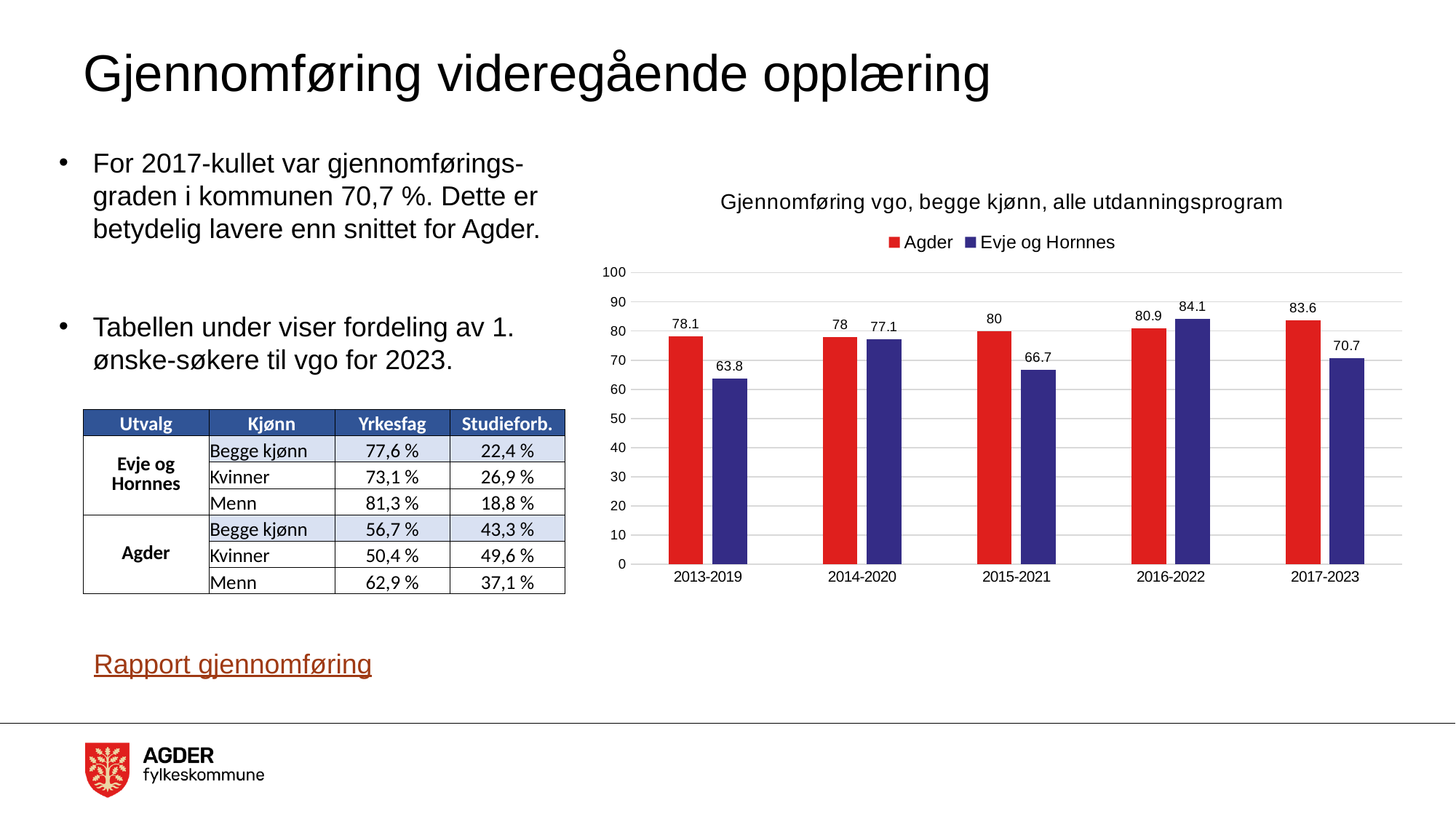
What is the difference between Agder and Evje og Hornnes in 2013-2019? 14.3 In which period is the Agder value highest? 2017-2023 Which is larger in 2016-2022, Agder or Evje og Hornnes? Evje og Hornnes In which period is the Evje og Hornnes value lowest? 2013-2019 What is the value for Evje og Hornnes in 2015-2021? 66.7 What is the value for Agder in 2013-2019? 78.1 How many periods are shown on the x axis? 5 Is the value for Evje og Hornnes in 2014-2020 greater or less than 70? greater What kind of chart is shown? Bar chart How many series does the legend list? 2 In which period is the Evje og Hornnes value highest? 2016-2022 What is the value for Evje og Hornnes in 2017-2023? 70.7